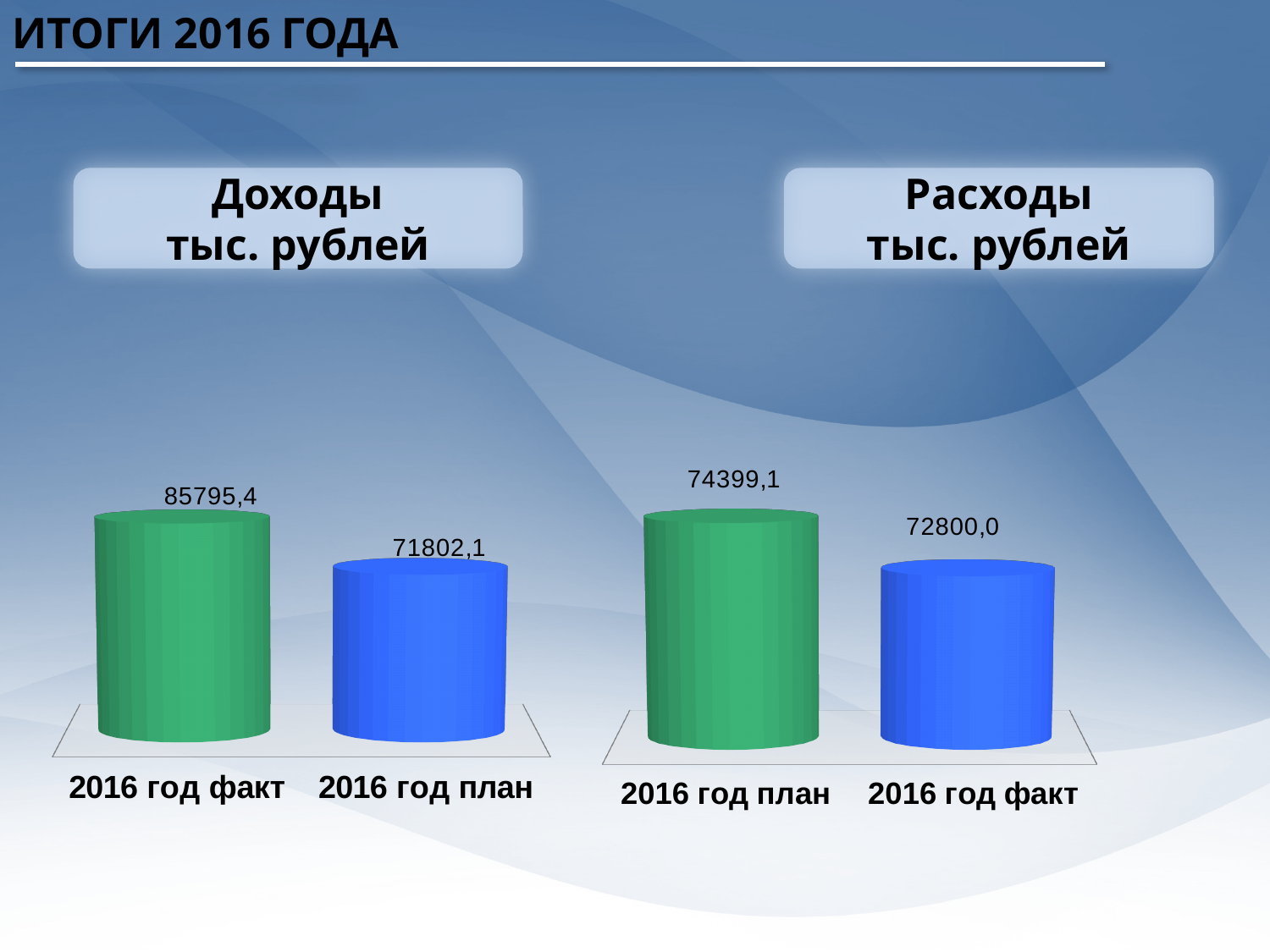
In the Расходы chart, which category has the lower value? 2016 год факт What type of chart is the Расходы chart? bar chart In the Расходы chart, which is larger: 2016 год план or 2016 год факт? 2016 год план In the Расходы chart, what is the value for 2016 год факт? 72800,0 In the Расходы chart, what is the value for 2016 год план? 74399,1 In the Доходы chart, what is the value for 2016 год факт? 85795,4 What colour is the 2016 год план bar in the Доходы chart? blue In the Расходы chart, what is the difference between the 2016 год план and 2016 год факт values? 1599,1 In the Доходы chart, what is the value for 2016 год план? 71802,1 How many bars does the Доходы chart show? 2 In the Доходы chart, what is the difference between the 2016 год факт and 2016 год план values? 13993,3 In the Доходы chart, which category has the higher value? 2016 год факт